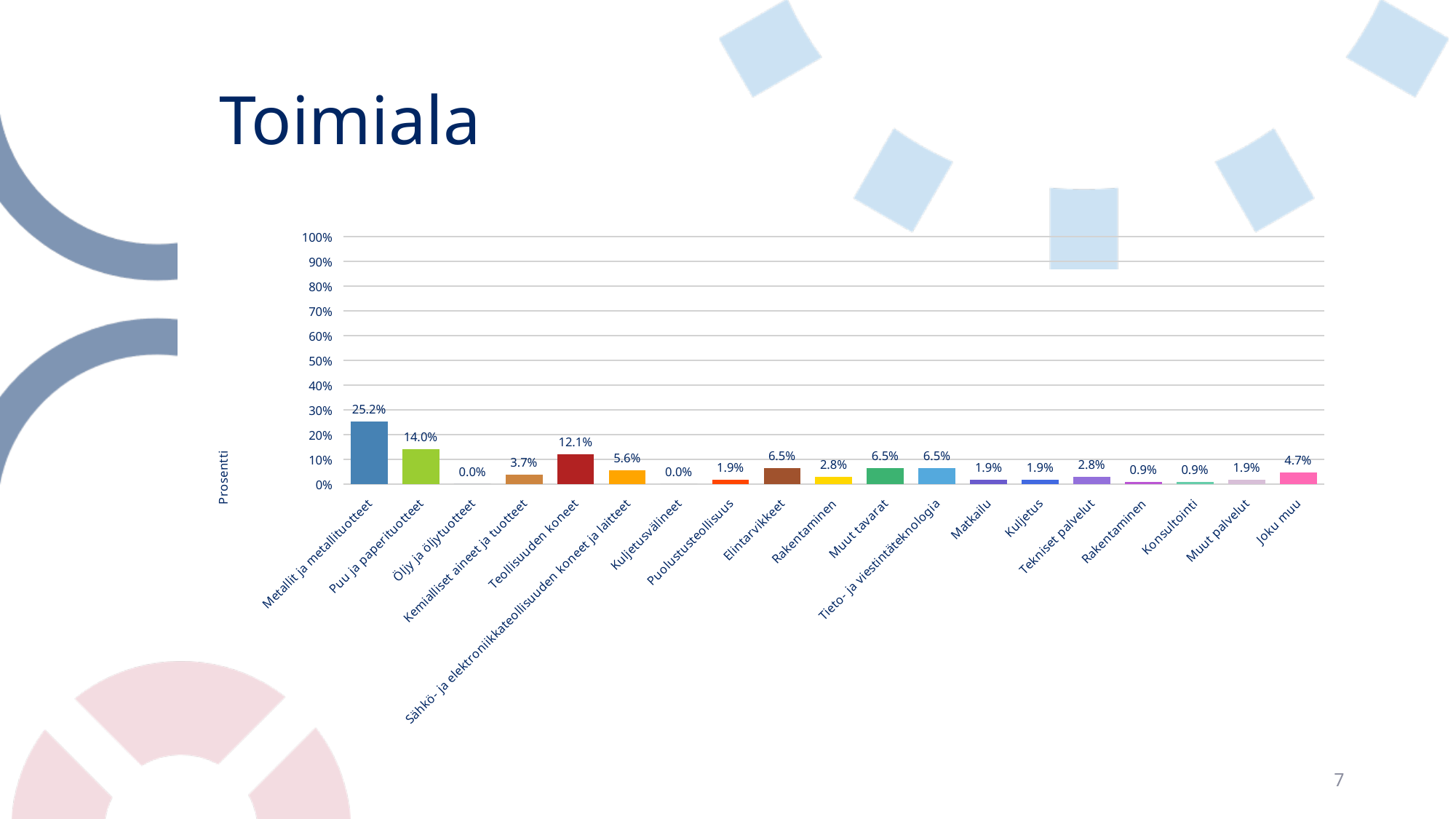
Which is larger, Puu ja paperituotteet or Teollisuuden koneet? Puu ja paperituotteet What is the value for Kemialliset aineet ja tuotteet? 3.7% What is the value for Joku muu? 4.7% What is the label on the vertical axis? Prosentti Is the value for Metallit ja metallituotteet greater or less than 20%? greater How many categories are shown on the x axis? 19 What is the difference between Metallit ja metallituotteet and Puu ja paperituotteet? 11.2% What kind of chart is shown on the slide? bar chart What is the difference between Teollisuuden koneet and Elintarvikkeet? 5.6% What is the value for Teollisuuden koneet? 12.1% Which category has the highest value? Metallit ja metallituotteet What is the value for Metallit ja metallituotteet? 25.2%